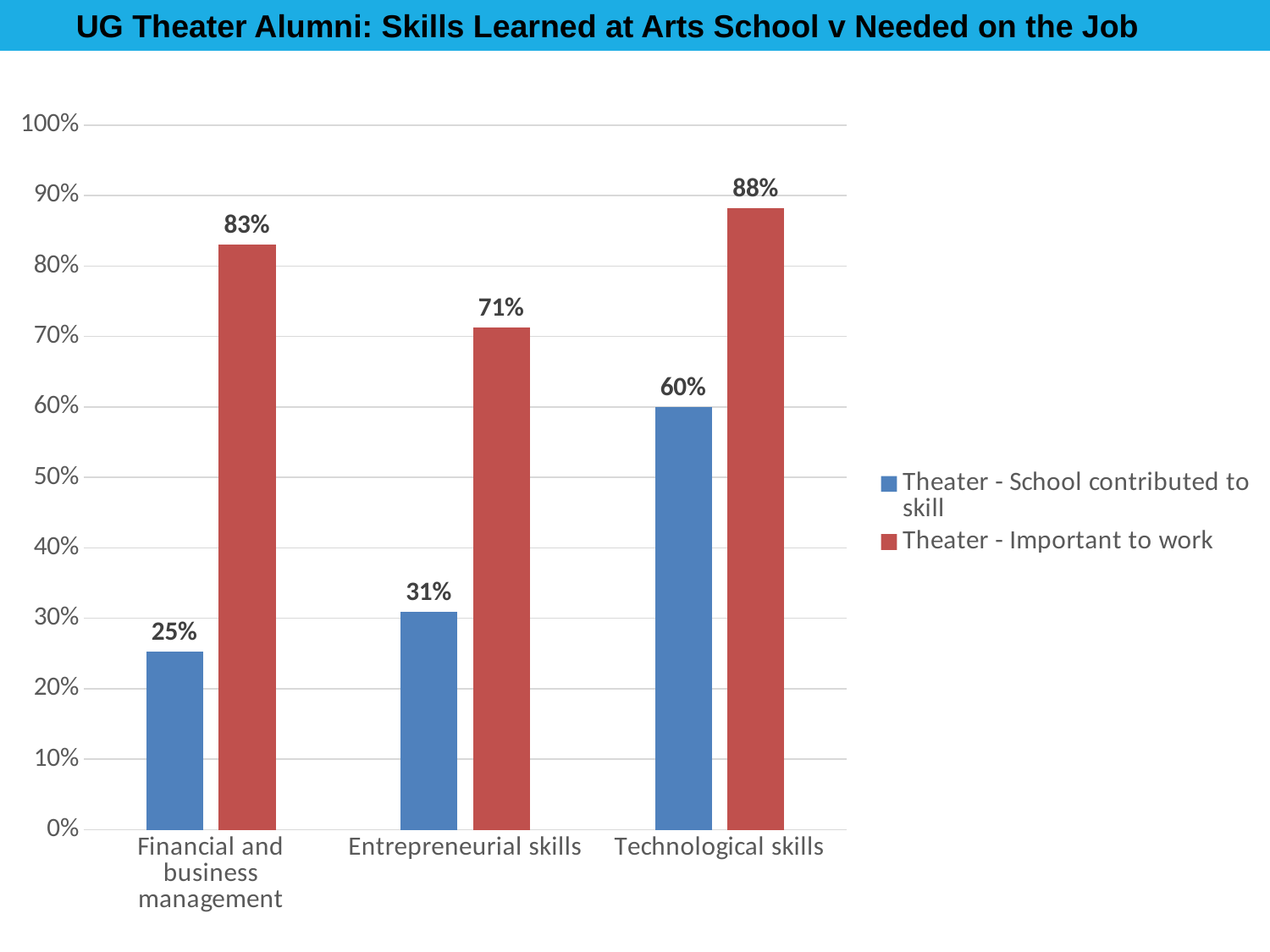
How many skill categories are shown on the x axis? 3 What is the difference between the 'Important to work' and 'School contributed to skill' values for Financial and business management? 58% What percentage of theater alumni said school contributed to their financial and business management skills? 25% How many series does the legend list? 2 What is the value for 'Theater - School contributed to skill' for Entrepreneurial skills? 31% For Technological skills, which is larger: 'School contributed to skill' or 'Important to work'? Important to work Which skill category has the highest 'Theater - Important to work' value? Technological skills What is the value for 'Theater - Important to work' for Technological skills? 88% Which skill category has the lowest 'Theater - School contributed to skill' value? Financial and business management What kind of chart is shown on the slide? Bar chart What colour are the bars for 'Theater - Important to work'? Red What is the difference between the 'Important to work' values for Technological skills and Entrepreneurial skills? 17%